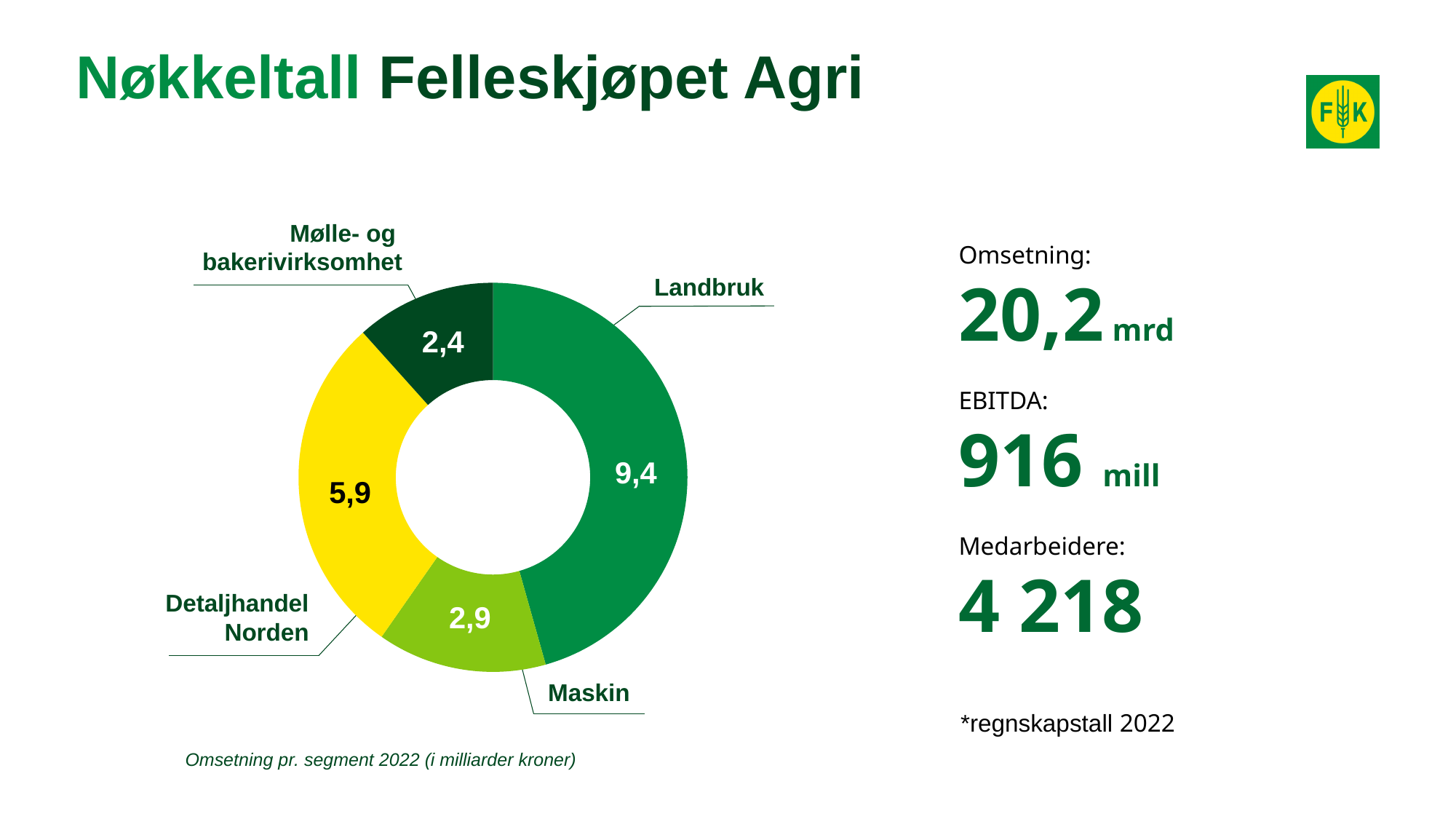
What is the caption below the chart? Omsetning pr. segment 2022 (i milliarder kroner) How many segments does the donut chart have? 4 What kind of chart is shown on the slide? Donut (pie) chart What is the difference between the values for Maskin and Mølle- og bakerivirksomhet? 0,5 Which is larger, the value for Maskin or the value for Mølle- og bakerivirksomhet? Maskin Which segment has the highest value in the donut chart? Landbruk What is the value for Detaljhandel Norden in the donut chart? 5,9 What is the value for Landbruk in the donut chart? 9,4 What is the value for Mølle- og bakerivirksomhet in the donut chart? 2,4 Which segment has the lowest value in the donut chart? Mølle- og bakerivirksomhet What is the value for Maskin in the donut chart? 2,9 What is the difference between the values for Landbruk and Detaljhandel Norden? 3,5